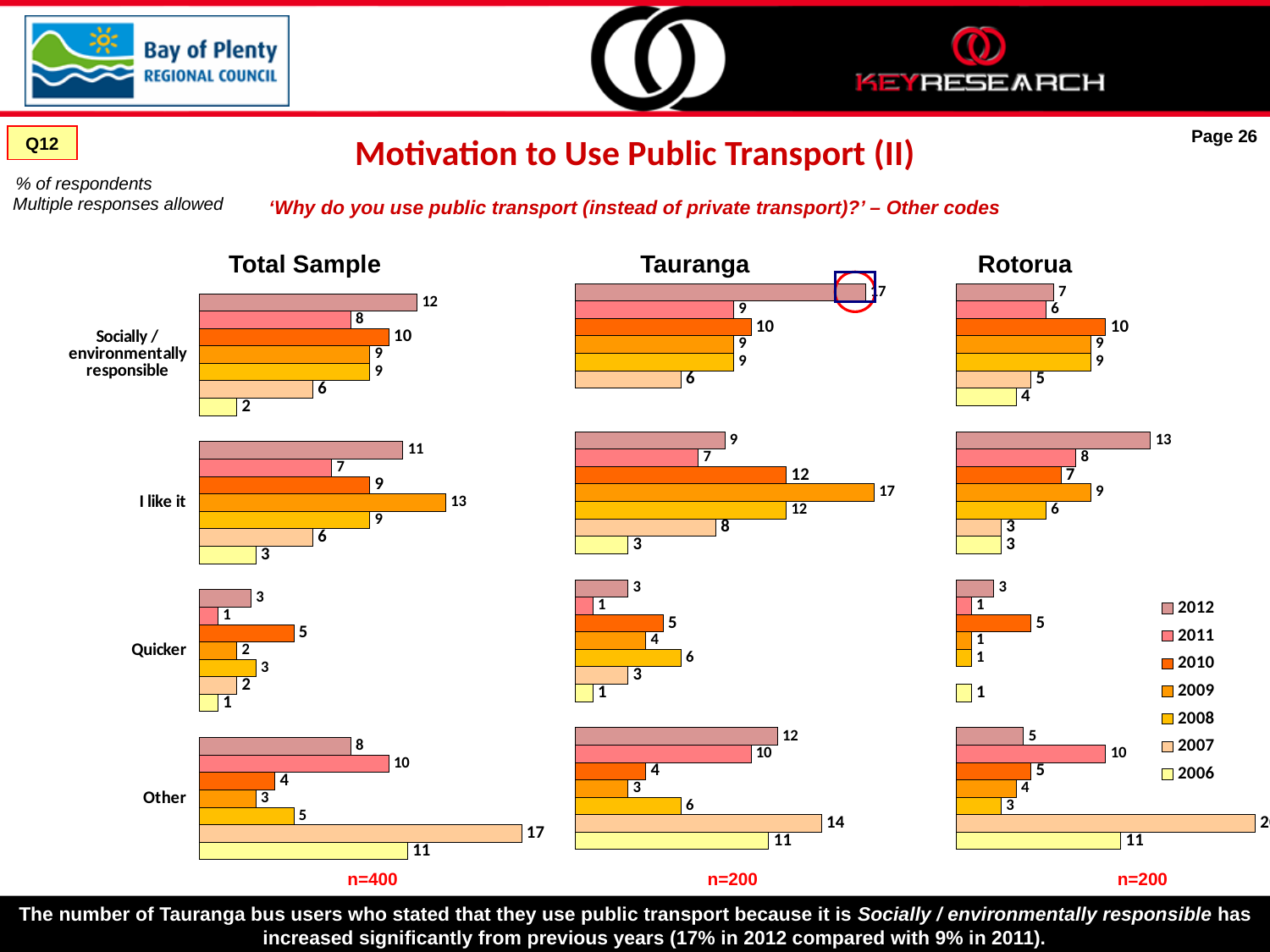
In the Tauranga chart, which year has the highest value for 'I like it'? 2009 What type of chart is used for the Tauranga data? Bar chart How many categories are shown on the y axis of the Total Sample chart? 4 In the Tauranga chart, what is the difference between the 2012 and 2011 values for 'Socially / environmentally responsible'? 8 In the Rotorua chart, which is larger for 'Other': the 2011 value or the 2012 value? 2011 In the Tauranga chart, what is the 2012 value for 'Socially / environmentally responsible'? 17 In the Total Sample chart, which year has the lowest value for 'Socially / environmentally responsible'? 2006 How many years does the legend list? 7 In the Total Sample chart, what is the 2007 value for 'Other'? 17 What is the sample size (n) shown under the Total Sample chart? n=400 In the Total Sample chart, what is the 2012 value for 'Socially / environmentally responsible'? 12 In the Rotorua chart, what is the 2012 value for 'I like it'? 13